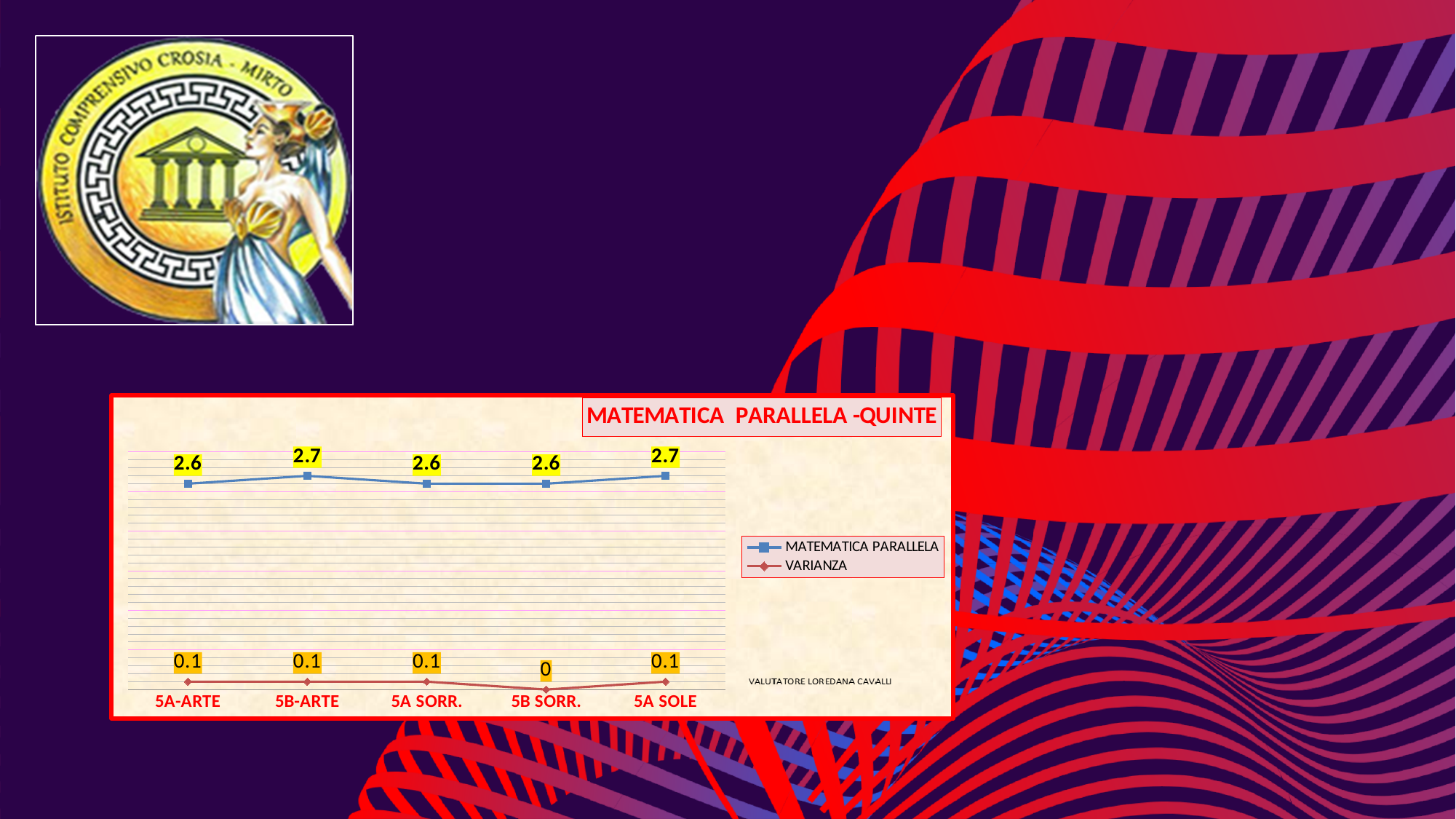
What is the VARIANZA value for 5B SORR.? 0 Which series is drawn in blue? MATEMATICA PARALLELA What is the difference between the MATEMATICA PARALLELA values for 5B-ARTE and 5A SORR.? 0.1 Which is larger, the MATEMATICA PARALLELA value for 5A SOLE or for 5B SORR.? 5A SOLE What is the MATEMATICA PARALLELA value for 5A-ARTE? 2.6 How many categories are shown on the x axis? 5 What is the MATEMATICA PARALLELA value for 5B-ARTE? 2.7 How many series does the legend list? 2 What is the VARIANZA value for 5A SOLE? 0.1 What kind of chart is shown? line chart What is the title of the chart? MATEMATICA PARALLELA -QUINTE Which category has the lowest VARIANZA value? 5B SORR.